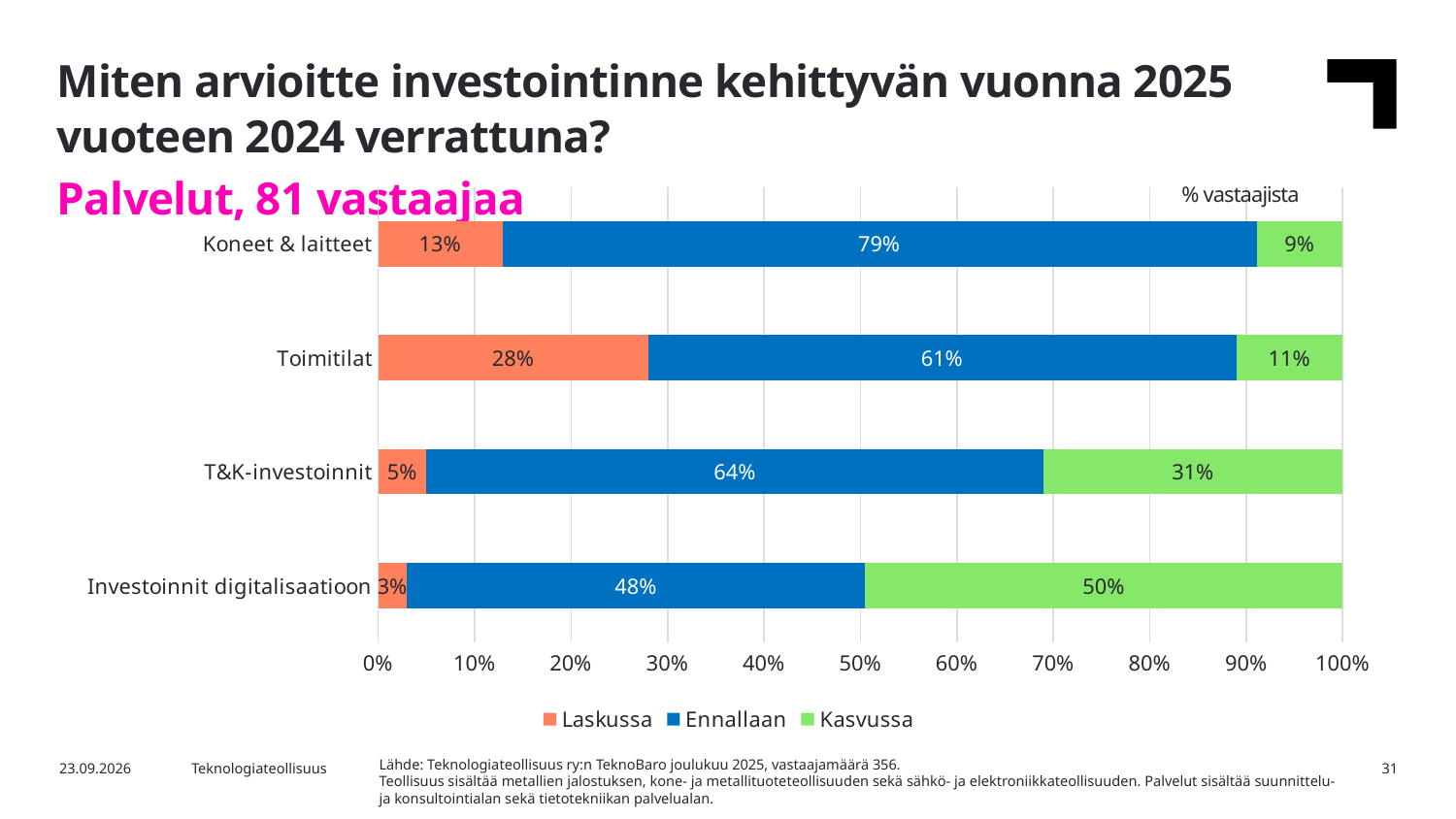
How many series does the legend list? 3 What is the difference between the Ennallaan values for Koneet & laitteet and Toimitilat? 18% What is the Laskussa value for T&K-investoinnit? 5% What are the three series listed in the legend? Laskussa, Ennallaan, Kasvussa What is the Ennallaan value for Koneet & laitteet? 79% What is the Laskussa value for Toimitilat? 28% Which is larger, the Kasvussa value for T&K-investoinnit or for Toimitilat? T&K-investoinnit What is the Kasvussa value for Investoinnit digitalisaatioon? 50% What kind of chart is shown on the slide? Stacked bar chart Which category has the lowest Laskussa value? Investoinnit digitalisaatioon How many categories are shown on the chart? 4 Which category has the highest Kasvussa value? Investoinnit digitalisaatioon